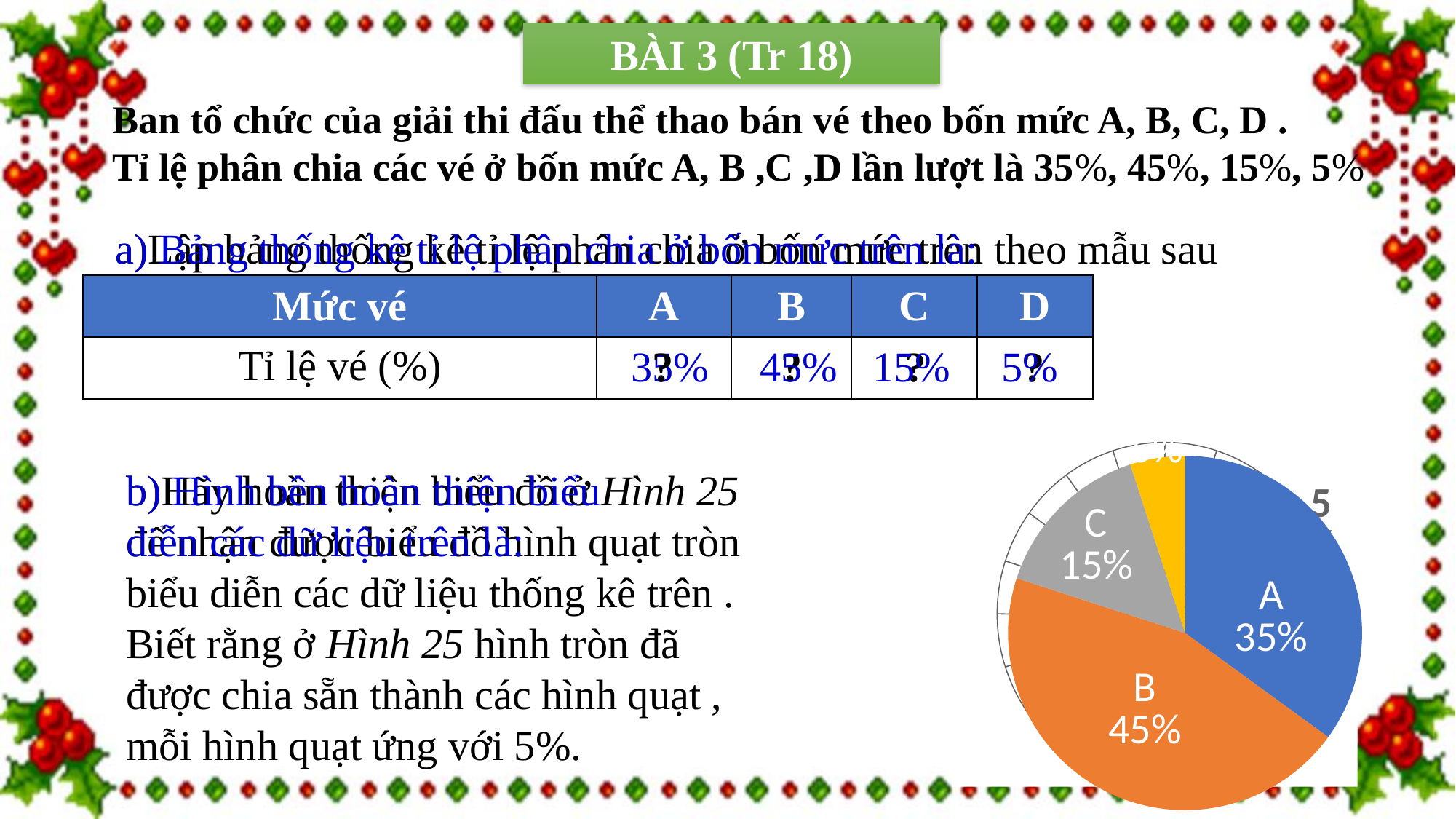
In the pie chart, what percentage is shown for slice A? 35% In the pie chart, what percentage is shown for slice C? 15% What is the combined percentage of slices A and B in the pie chart? 80% What kind of chart is shown on the slide? pie chart What colour is slice B in the pie chart? orange Which is larger in the pie chart, slice A or slice C? A What colour is slice A in the pie chart? blue What is the difference between the percentages of slices B and A in the pie chart? 10% How many slices does the pie chart have? 4 Which labelled slice of the pie chart is the largest? B In the pie chart, what percentage is shown for slice B? 45% Which slice of the pie chart is the smallest? the yellow slice (D)